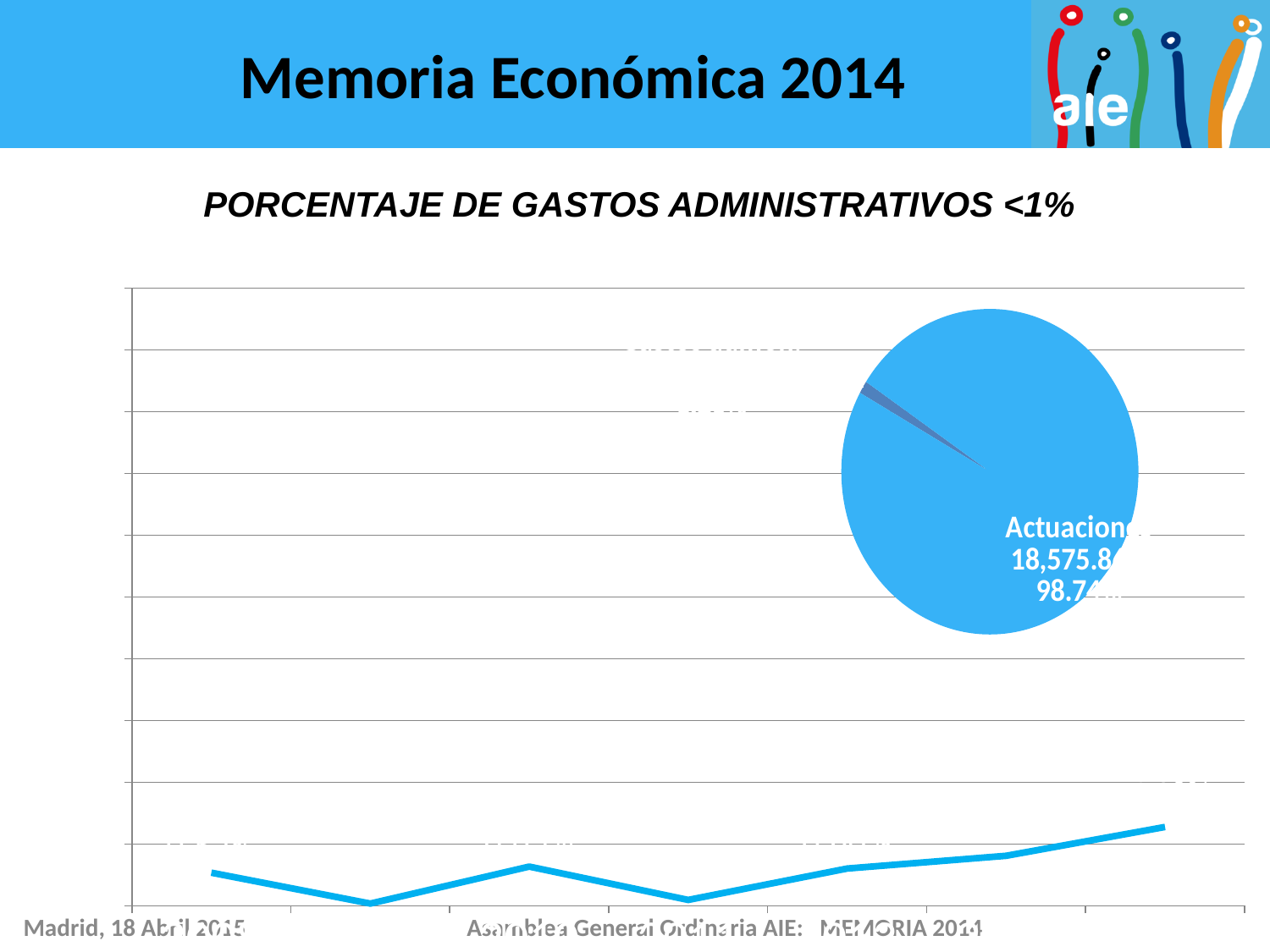
In the pie chart, which slice is larger: the light blue slice or the dark blue slice? the light blue slice How many slices does the pie chart have? 2 What kind of chart is shown along the bottom of the slide? line chart What colour is the large slice of the pie chart? light blue In the pie chart, is the light blue slice's share greater or less than 50%? greater What is the heading printed above the charts? PORCENTAJE DE GASTOS ADMINISTRATIVOS <1% In the line chart, does the line end higher or lower than where it starts? higher What kind of chart is shown in the upper right of the slide? pie chart